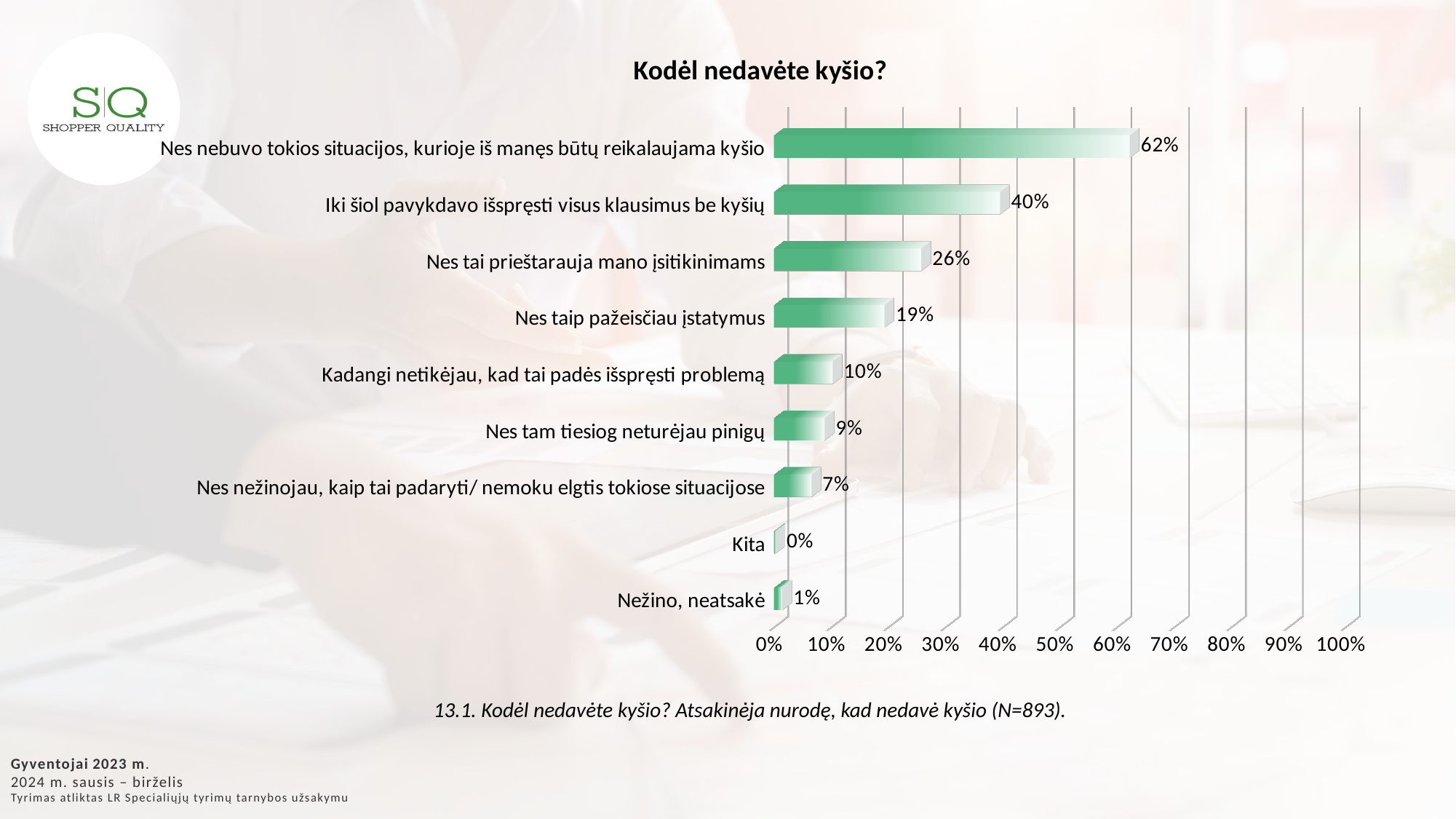
Which category has the lowest value? Kita What is the difference between "Nes nebuvo tokios situacijos, kurioje iš manęs būtų reikalaujama kyšio" and "Iki šiol pavykdavo išspręsti visus klausimus be kyšių"? 22% What is the value for "Kita"? 0% Which is larger: "Nes tai prieštarauja mano įsitikinimams" or "Nes taip pažeisčiau įstatymus"? Nes tai prieštarauja mano įsitikinimams What is the value for "Nes tam tiesiog neturėjau pinigų"? 9% Which category has the highest value? Nes nebuvo tokios situacijos, kurioje iš manęs būtų reikalaujama kyšio What is the value for "Iki šiol pavykdavo išspręsti visus klausimus be kyšių"? 40% What is the title of the chart? Kodėl nedavėte kyšio? What kind of chart is shown on the slide? Bar chart Is the value for "Kadangi netikėjau, kad tai padės išspręsti problemą" greater or less than 20%? less What is the value for "Nes nebuvo tokios situacijos, kurioje iš manęs būtų reikalaujama kyšio"? 62% How many categories are shown in the chart? 9